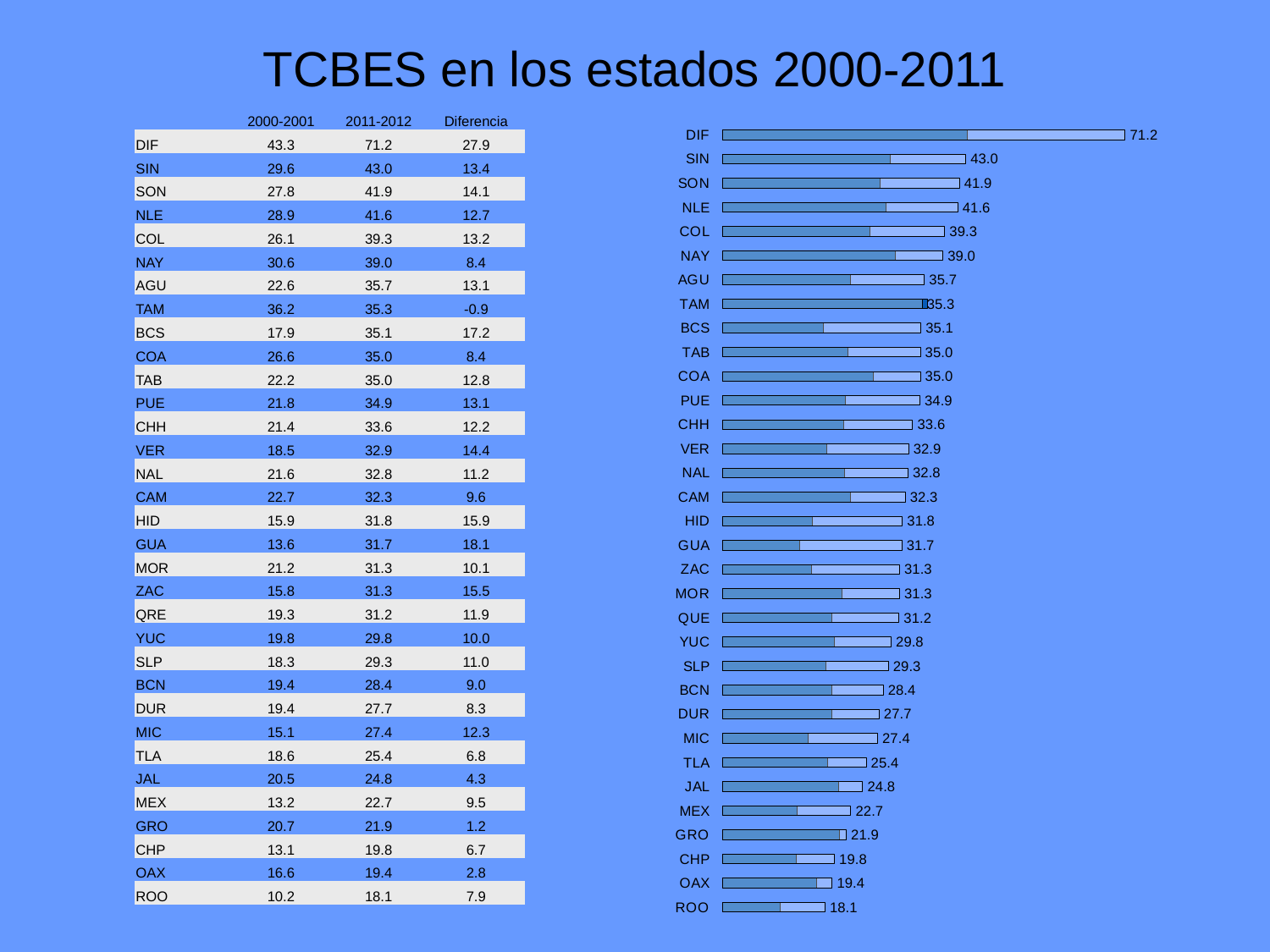
Do the labelled values in the bar chart increase or decrease going from the top bar to the bottom bar? decrease In the bar chart, what is the difference between the labelled values for COL and NAY? 0.3 In the bar chart, what is the difference between the labelled values for DIF and SIN? 28.2 Which state has the longest bar in the bar chart? DIF In the bar chart, what value is labelled for CHH? 33.6 How many states are listed in the bar chart? 33 In the bar chart, what value is labelled for ROO? 18.1 In the bar chart, which has the larger labelled value, SIN or SON? SIN In the bar chart, what value is labelled for NLE? 41.6 What kind of chart is shown on the right side of the slide? bar chart Which state has the shortest bar in the bar chart? ROO In the bar chart, what value is labelled for DIF? 71.2